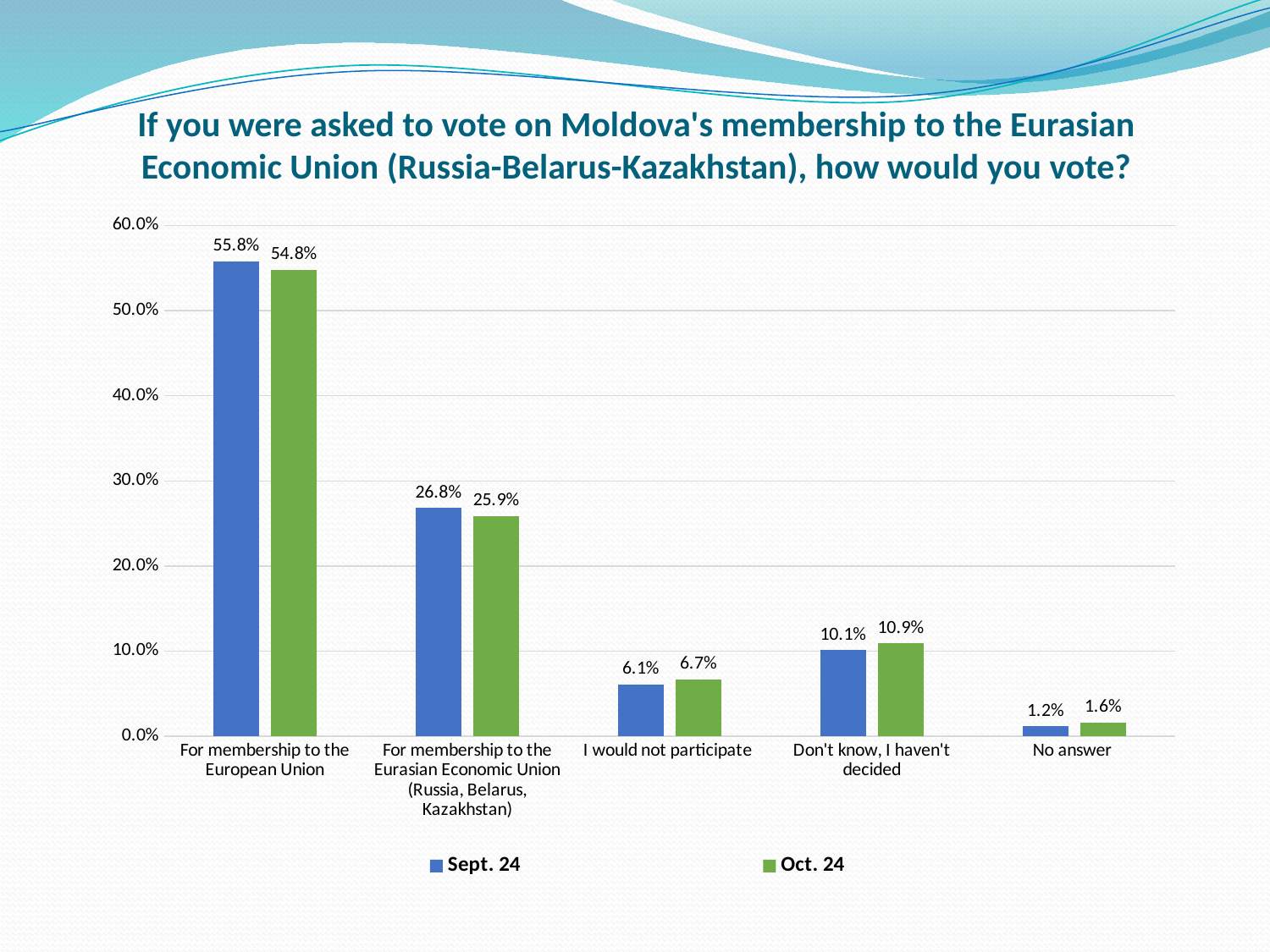
Which category has the highest Sept. 24 value? For membership to the European Union What is the Oct. 24 value for "For membership to the Eurasian Economic Union (Russia, Belarus, Kazakhstan)"? 25.9% Which category has the lowest Oct. 24 value? No answer How many categories are shown on the x axis? 5 Which series is shown in green in the legend? Oct. 24 What is the Oct. 24 value for "No answer"? 1.6% What is the Sept. 24 value for "For membership to the European Union"? 55.8% Which is larger for "Don't know, I haven't decided": the Sept. 24 value or the Oct. 24 value? Oct. 24 What kind of chart is shown on the slide? Bar chart How many series does the legend list? 2 Is the Sept. 24 value for "I would not participate" greater or less than 10.0%? less What is the difference between the Sept. 24 and Oct. 24 values for "For membership to the European Union"? 1.0%